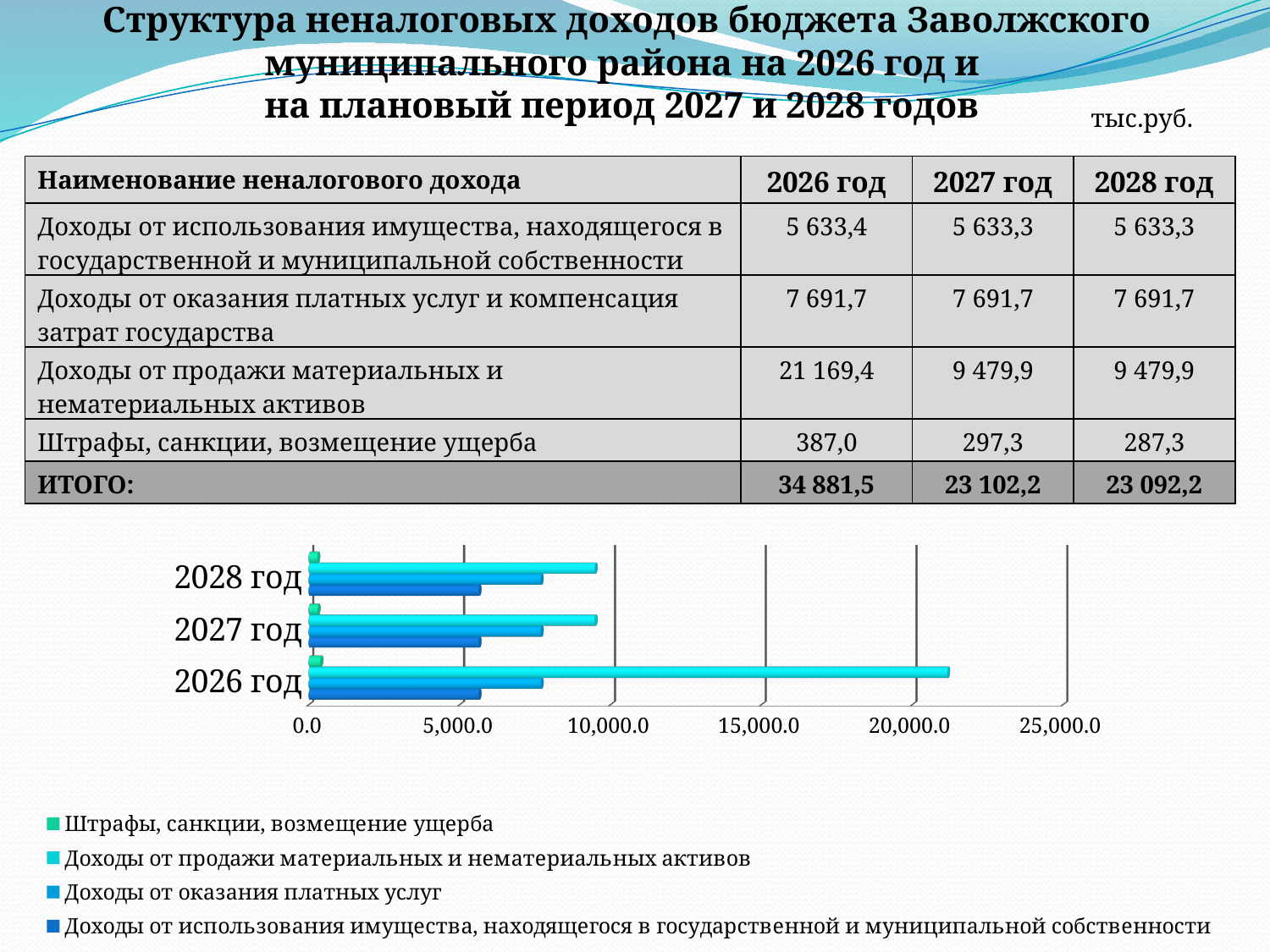
Is the bar for 'Доходы от оказания платных услуг' in 2028 год greater or less than 5,000.0? greater In 2026 год, which is larger: 'Доходы от оказания платных услуг' or 'Доходы от использования имущества, находящегося в государственной и муниципальной собственности'? Доходы от оказания платных услуг By how much does 'Доходы от продажи материальных и нематериальных активов' in 2026 год exceed the value in 2027 год? 11 689,5 Do the values for 'Штрафы, санкции, возмещение ущерба' rise or fall from 2026 год to 2028 год? fall For which year is the bar for 'Доходы от продажи материальных и нематериальных активов' the longest? 2026 год What kind of chart is shown on the slide? bar chart How many year categories are plotted on the chart's vertical axis? 3 Is the bar for 'Доходы от продажи материальных и нематериальных активов' in 2027 год greater or less than 10,000.0? less How many series does the chart legend list? 4 What is the value of 'Доходы от продажи материальных и нематериальных активов' for 2026 год? 21 169,4 What is the value of 'Штрафы, санкции, возмещение ущерба' for 2028 год? 287,3 Is the bar for 'Доходы от продажи материальных и нематериальных активов' in 2026 год greater or less than 20,000.0? greater